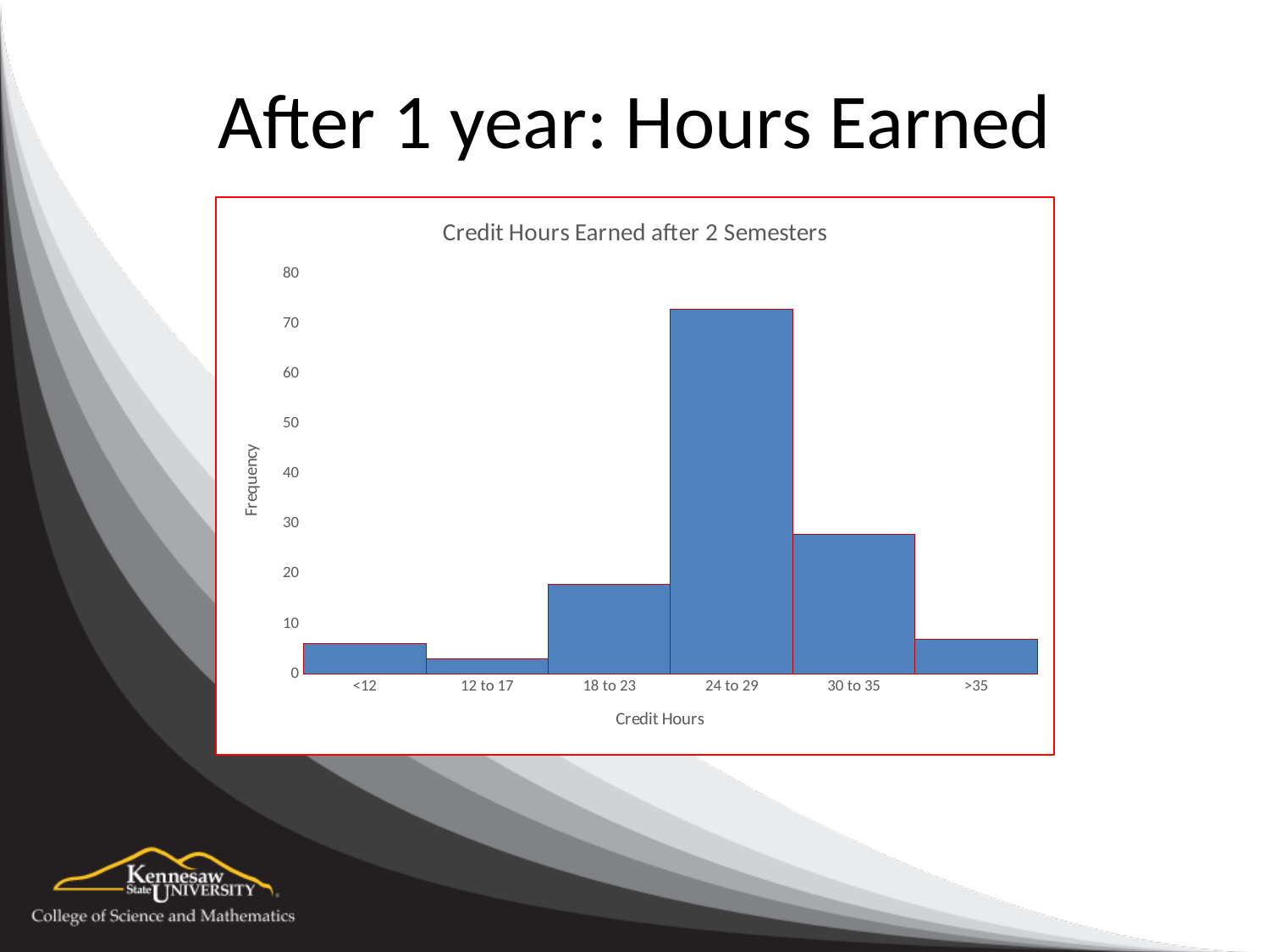
Is the frequency for the 18 to 23 category greater or less than 10? greater What is the title of the chart? Credit Hours Earned after 2 Semesters What kind of chart is shown on the slide? bar chart Which has the higher frequency, the 30 to 35 category or the 18 to 23 category? 30 to 35 How many credit-hour categories are shown on the x axis? 6 Which credit-hour category has the lowest frequency? 12 to 17 Is the frequency for the >35 category greater or less than 10? less Is the frequency for the 24 to 29 category greater or less than 60? greater Which credit-hour category has the highest frequency? 24 to 29 What is the label on the vertical axis of the chart? Frequency